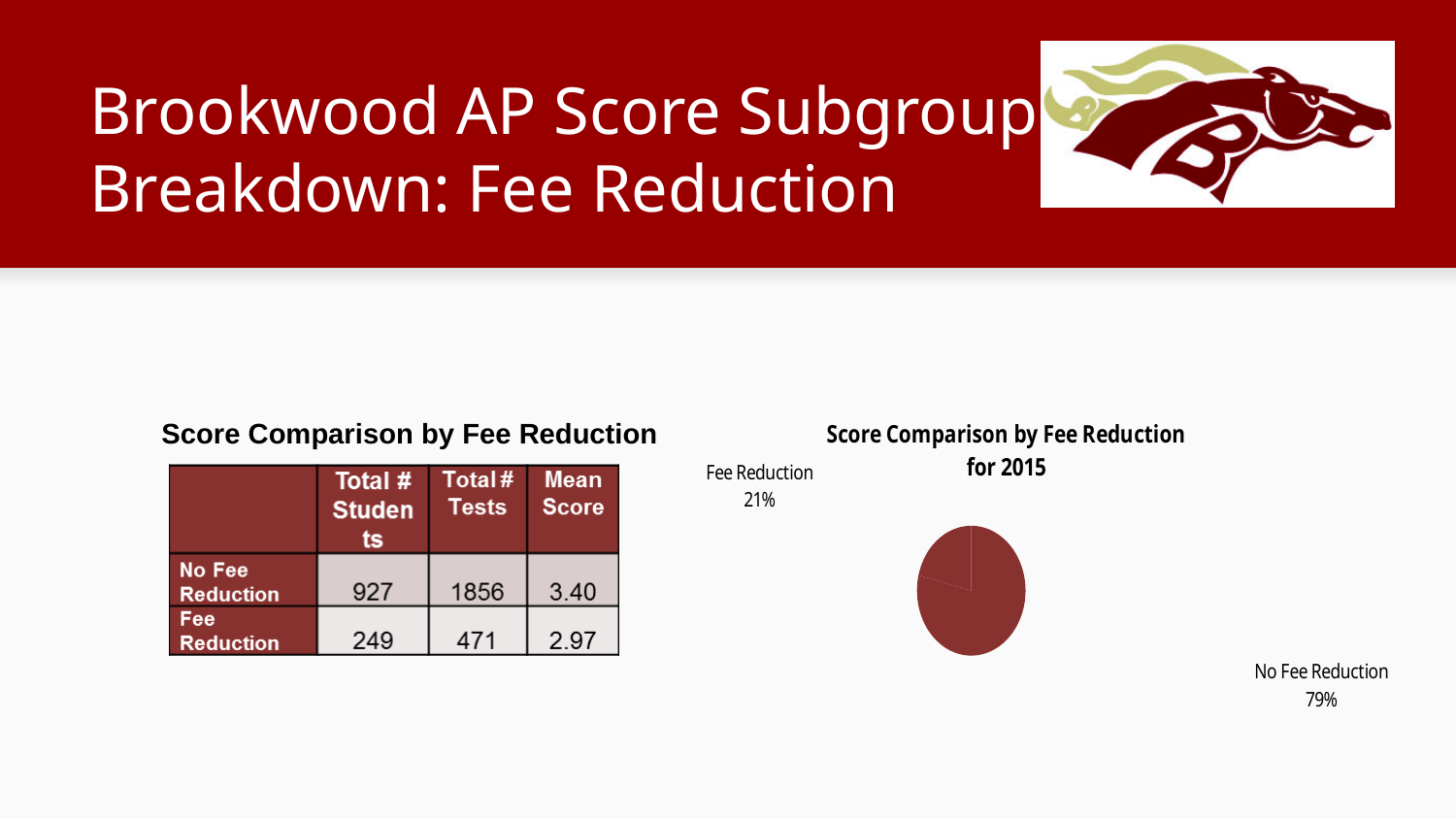
How many slices does the pie chart have? 2 What year does the pie chart's title say the data is for? 2015 In the pie chart, what share is labelled for No Fee Reduction? 79% Is the Fee Reduction share in the pie chart greater or less than 50%? less Which slice of the pie chart is the smallest? Fee Reduction Which slice of the pie chart is the largest? No Fee Reduction In the pie chart, what is the difference in percentage points between the No Fee Reduction share and the Fee Reduction share? 58 What is the title of the pie chart? Score Comparison by Fee Reduction for 2015 In the pie chart, which is larger: the Fee Reduction slice or the No Fee Reduction slice? No Fee Reduction What kind of chart is shown on the slide? pie chart Is the No Fee Reduction share in the pie chart greater or less than 50%? greater In the pie chart, what share is labelled for Fee Reduction? 21%